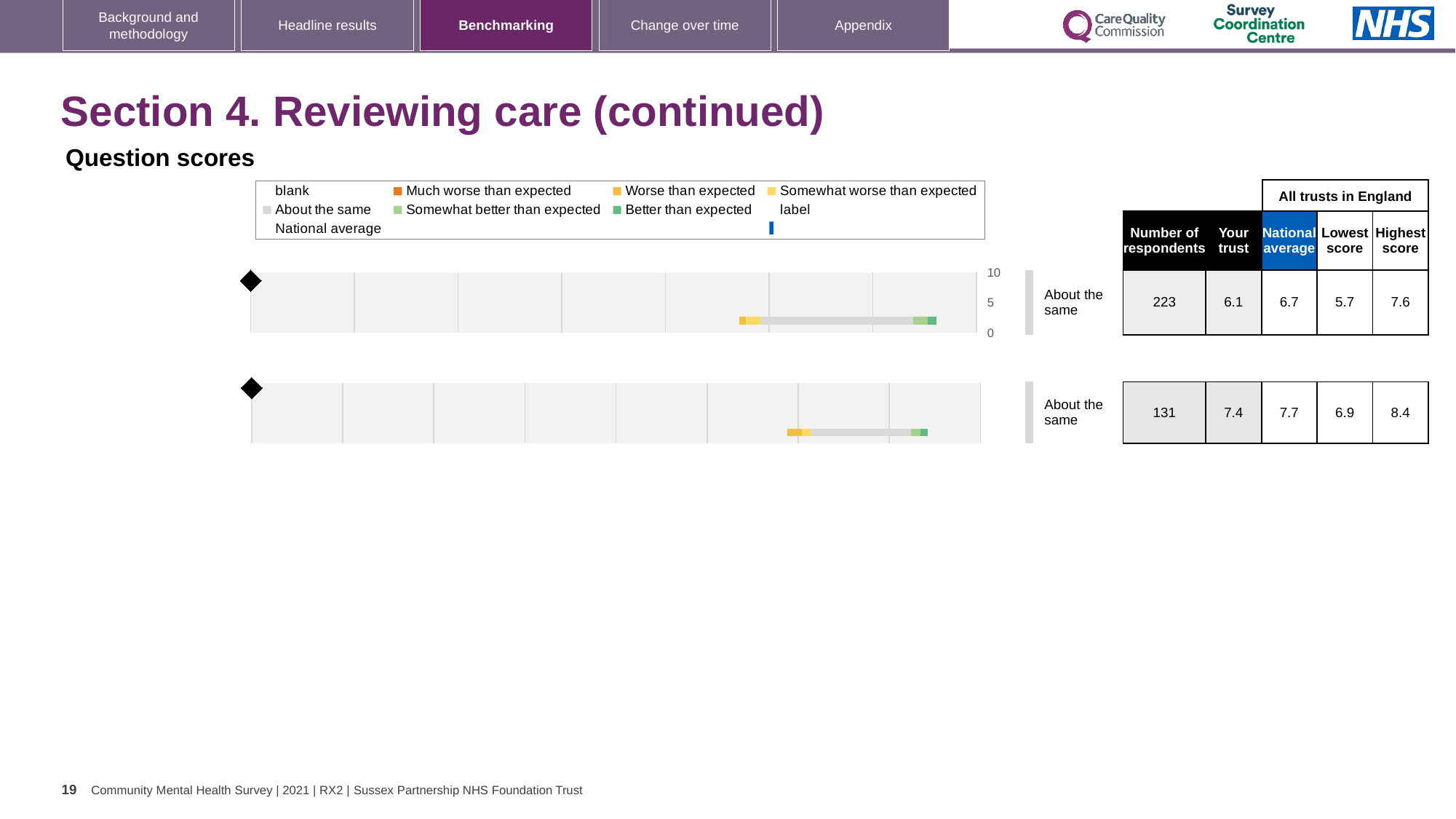
For the bottom chart, what is the highest score among all trusts in England? 8.4 For the bottom chart, how many respondents are listed? 131 What is the highest tick value shown on the score axis of the top chart? 10 For the top chart, what is the 'Your trust' score shown in the table? 6.1 For the top chart, what is the difference between the national average and the 'Your trust' score? 0.6 What kind of chart is used on this slide to show the question scores? bar chart For the bottom chart, what is the difference between the highest score and the lowest score? 1.5 For the top chart, what is the national average score? 6.7 For the bottom chart, what is the 'Your trust' score? 7.4 For the top chart, which is larger: the 'Your trust' score or the national average? National average What benchmark category label is shown next to the top chart? About the same For the top chart, how many respondents are listed? 223